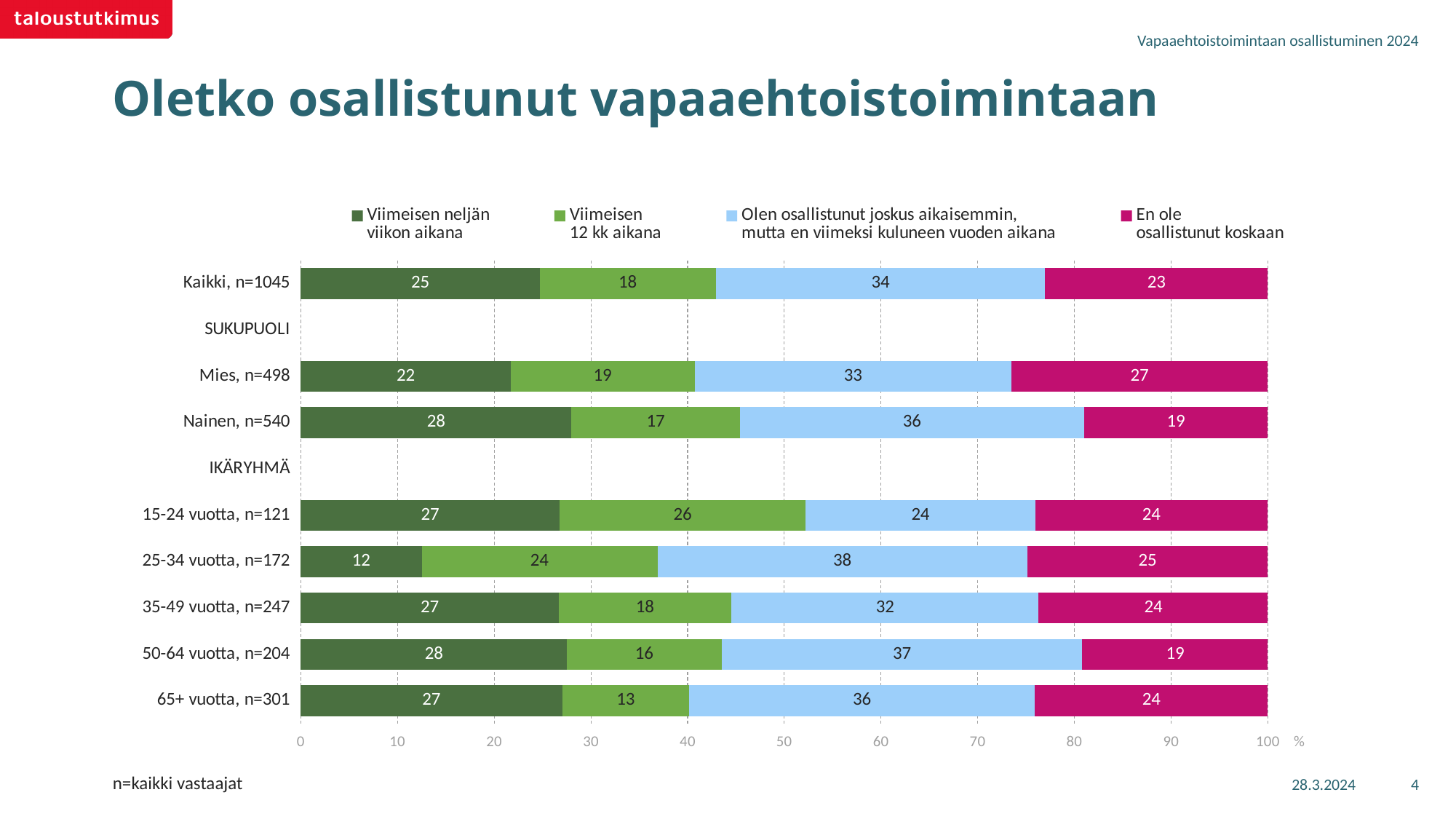
What is the difference between the "En ole osallistunut koskaan" values for Mies, n=498 and Nainen, n=540? 8 What is the value of "Viimeisen 12 kk aikana" for 65+ vuotta, n=301? 13 What is the value of "Viimeisen neljän viikon aikana" for Kaikki, n=1045? 25 Which group has the highest value for "Viimeisen 12 kk aikana"? 15-24 vuotta, n=121 What is the total of the stacked bar for 15-24 vuotta, n=121? 101 What is the value of "Olen osallistunut joskus aikaisemmin, mutta en viimeksi kuluneen vuoden aikana" for 25-34 vuotta, n=172? 38 How many series does the legend list? 4 Which is larger: the "Viimeisen neljän viikon aikana" value for Mies, n=498 or for Nainen, n=540? Nainen, n=540 How many groups (bars) are plotted in the chart? 8 What is the value of "En ole osallistunut koskaan" for Mies, n=498? 27 Which group has the lowest value for "Viimeisen neljän viikon aikana"? 25-34 vuotta, n=172 What kind of chart is shown on the slide? stacked bar chart